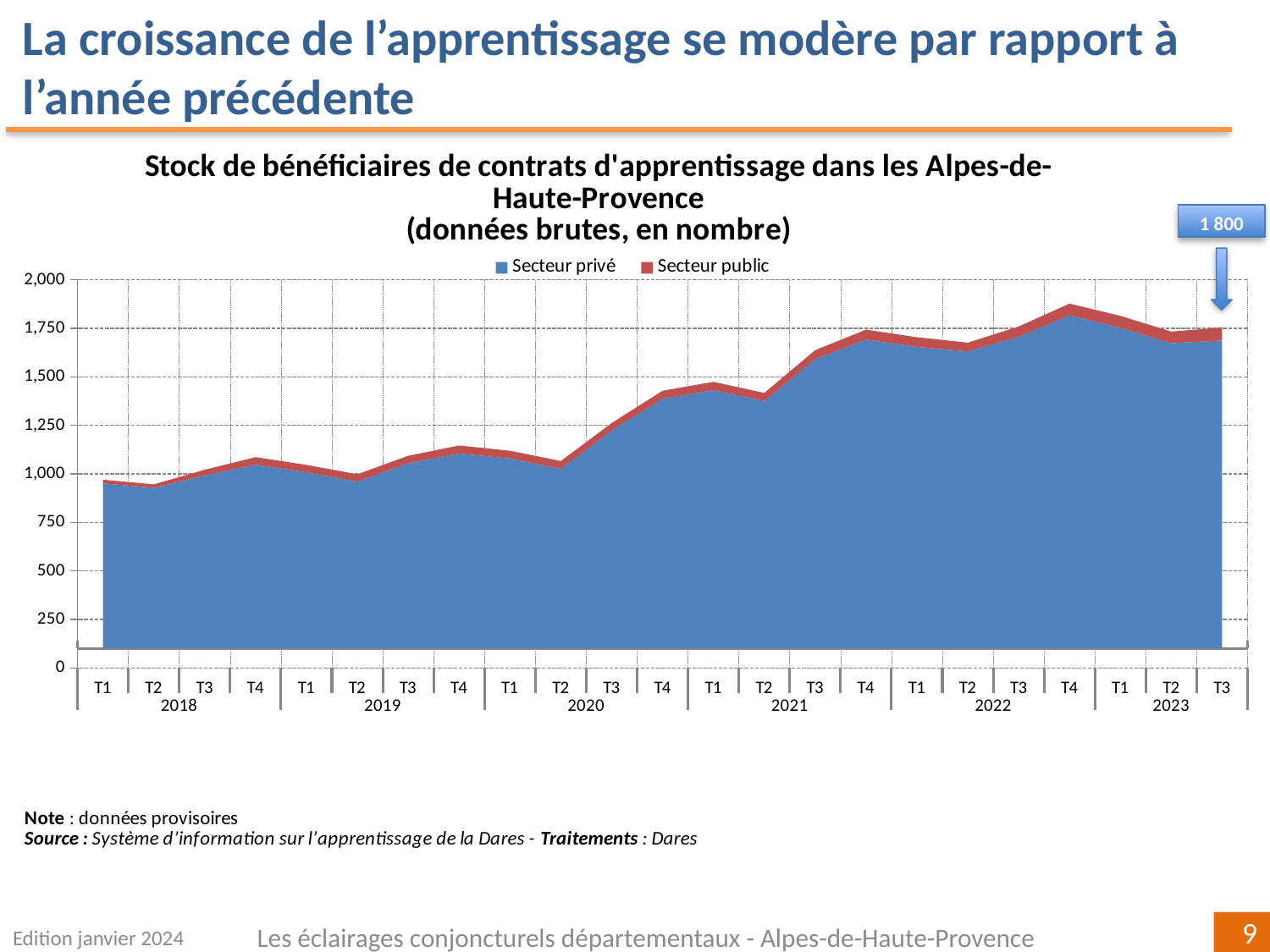
Is the total stock for T2 2018 greater or less than 1,000? less In which quarter does the total stock reach its highest point? T4 2022 Is the total stock for T4 2021 greater or less than 1,500? greater Is the total stock for T4 2022 greater or less than 1,750? greater Which is larger, the total stock in T4 2020 or in T4 2021? T4 2021 Overall, does the total stock rise or fall from 2018 to 2023? Rise Which series accounts for the larger share of the stock, Secteur privé or Secteur public? Secteur privé How many quarterly data points are plotted along the x axis? 23 What kind of chart is shown on the slide? Area chart What are the two series named in the legend? Secteur privé and Secteur public How many series does the legend list? 2